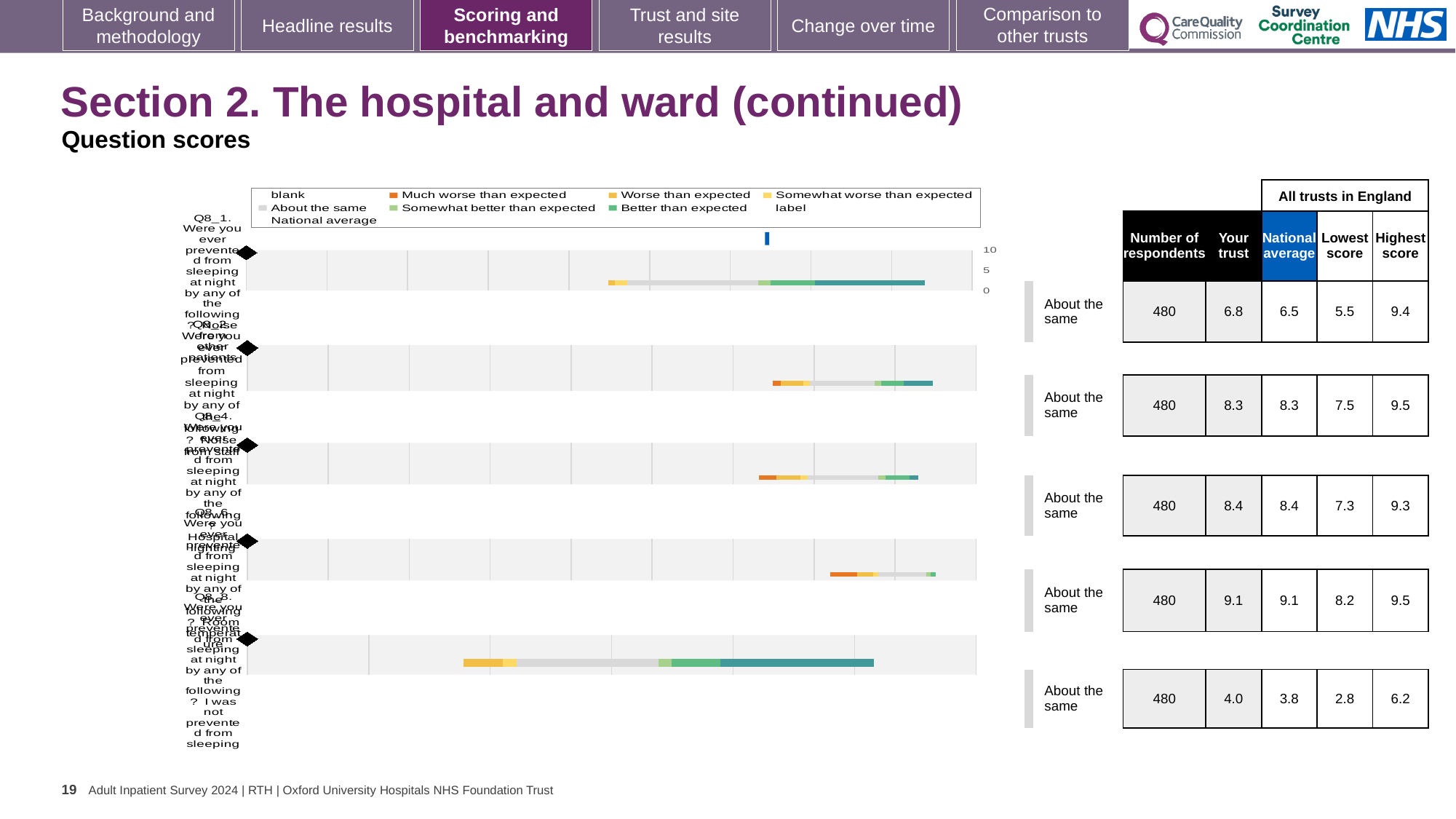
For Q8_8 (fifth row), what is the difference between the highest score and the lowest score across all trusts in England? 3.4 For Q8_1, how much higher is the 'Your trust' score than the national average? 0.3 What is the national average for the first row, Q8_1? 6.5 Which question row has the lowest 'Your trust' score? Q8_8 (fifth row), 4.0 What kind of chart is shown on the slide? bar chart What is the 'Your trust' score for the last row, Q8_8? 4.0 What benchmark category is shown next to every bar in the chart? About the same How many respondents are listed for each question row? 480 What is the 'Your trust' score for the first row, Q8_1? 6.8 Which has the larger 'Your trust' score, Q8_2 (second row) or Q8_4 (third row)? Q8_4 (8.4) How many question rows (bars) are plotted in the chart? 5 Which question row has the highest 'Your trust' score? Q8_6 (fourth row), 9.1